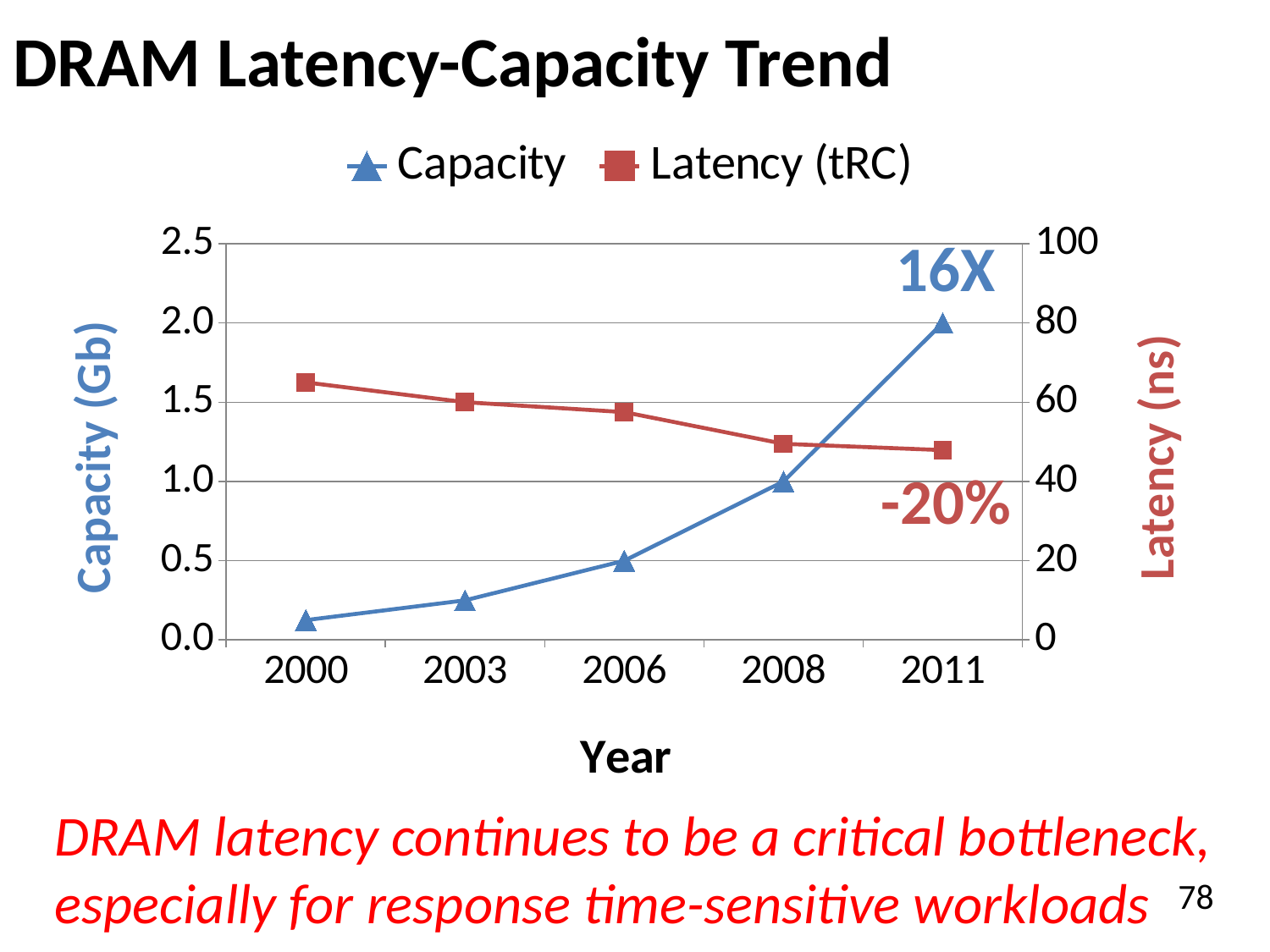
Which year has the highest Latency (tRC) value? 2000 Is the Capacity value for 2006 greater or less than 1.0? less Does the Latency (tRC) series rise or fall from 2000 to 2011? fall What is the label of the left vertical axis? Capacity (Gb) What kind of chart is shown on the slide? line chart How many series does the legend list? 2 How many years are plotted along the x axis? 5 What is the Capacity value for 2011? 2.0 What is the Capacity value for 2008? 1.0 Does the Capacity series rise or fall from 2000 to 2011? rise Is the Latency (tRC) value for 2000 greater or less than 60? greater Is the Latency (tRC) value for 2011 greater or less than 60? less